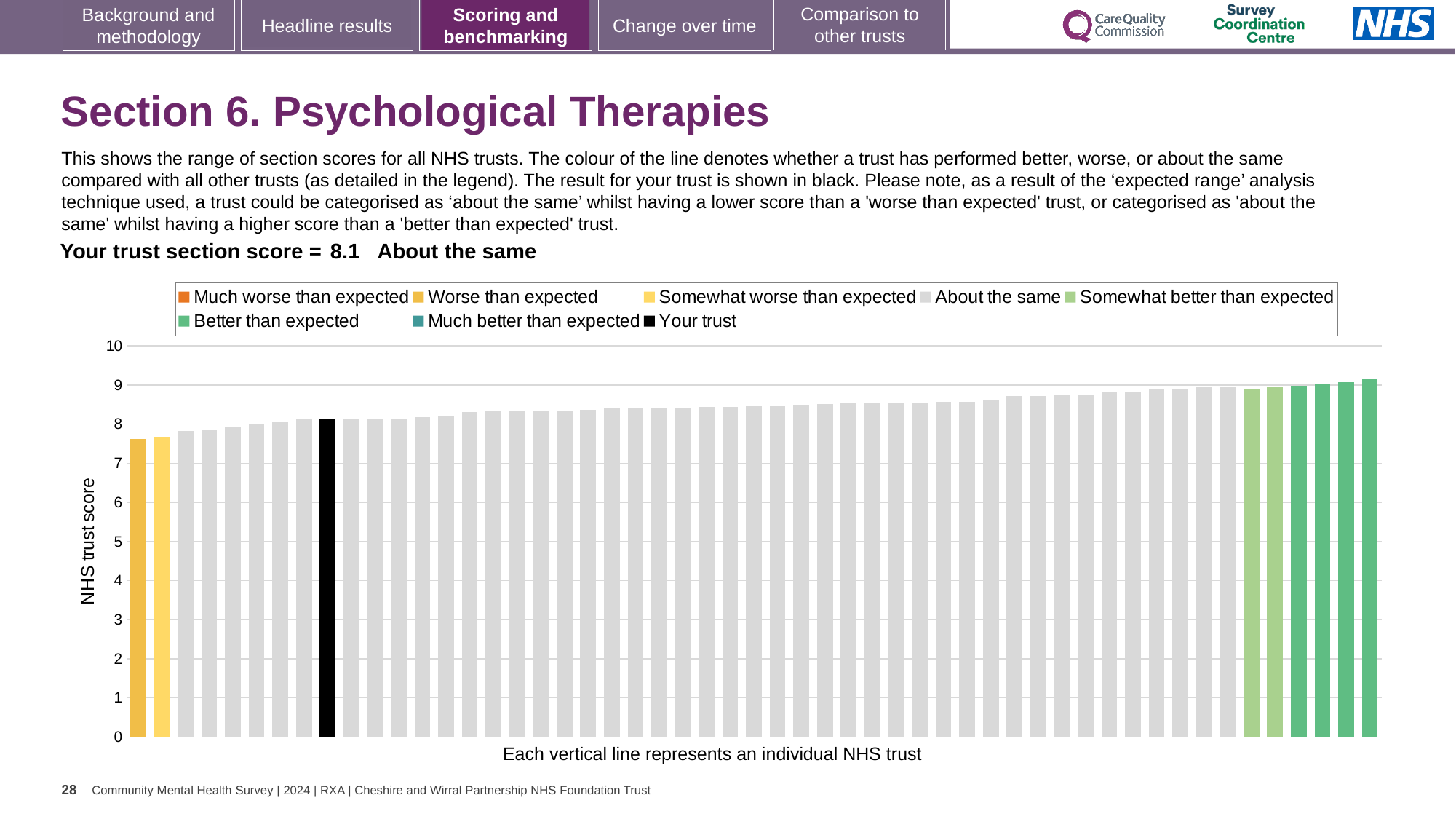
Which legend category do the bars with the highest scores (rightmost, dark green) belong to? Better than expected Is the value of the highest bar in the chart greater or less than 10? less Which performance category is your trust placed in for this section? About the same What colour is used to show your trust in the chart? black Do the bar values rise or fall moving from left to right along the x axis? rise What is the section score for your trust shown on the slide? 8.1 What kind of chart is shown on the slide? bar chart How many entries does the chart legend list? 8 Which is larger: the black bar for your trust or the first yellow bar on the left? the black bar for your trust Is the value for your trust (the black bar) greater or less than 8? greater What is the label on the vertical axis of the chart? NHS trust score Is the value of the lowest bar in the chart greater or less than 8? less